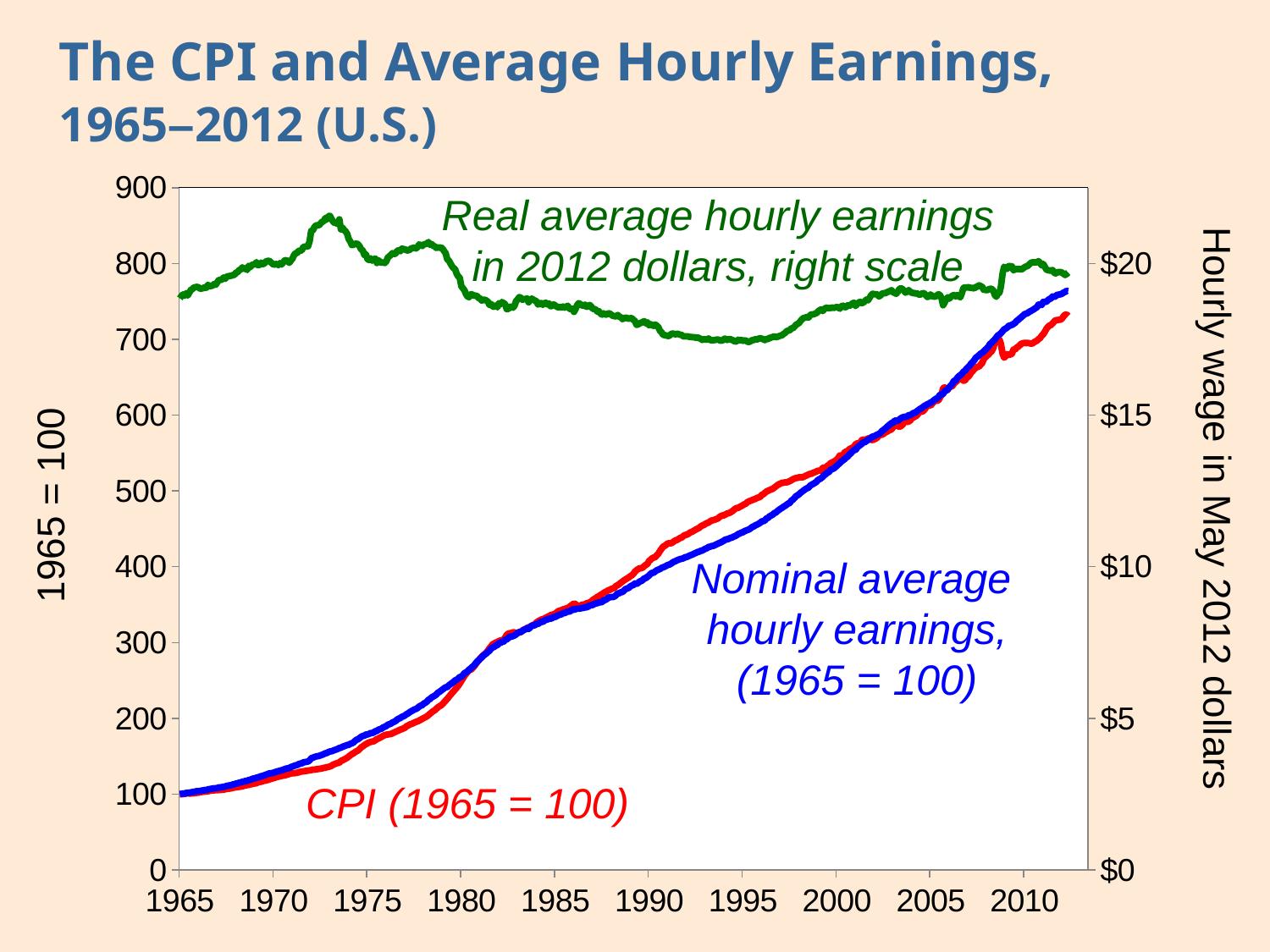
In 1975, which is higher: the CPI series or the nominal average hourly earnings series? Nominal average hourly earnings Does the real average hourly earnings series rise or fall between 1973 and 1995? fall In 1995, which is higher: the CPI series or the nominal average hourly earnings series? CPI How many data series are labelled on the chart? 3 What is the title of the chart? The CPI and Average Hourly Earnings, 1965–2012 (U.S.) What is the value of the nominal average hourly earnings index in 1965? 100 What is the value of the CPI series in 1965? 100 What kind of chart is shown on the slide? line chart Is the value of the CPI series in 2012 greater or less than 700? greater What is the label of the right-hand vertical axis? Hourly wage in May 2012 dollars Is the real average hourly earnings value in 1995 greater or less than $20? less Does the CPI series rise or fall from 1965 to 2012? rise